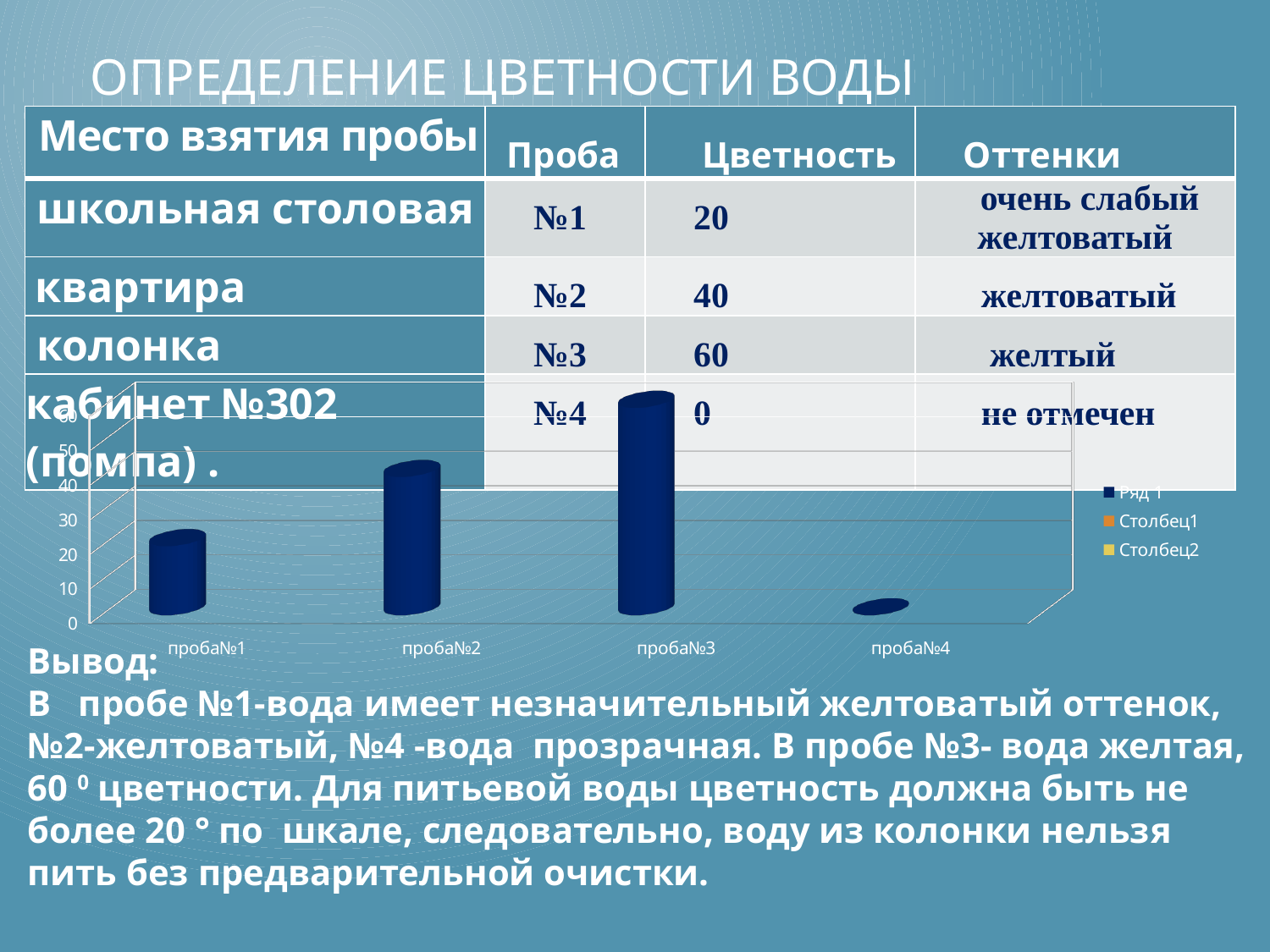
What is the colour value (цветность) plotted for проба№1? 20 Is the value for проба№2 greater or less than 30? greater What kind of chart is shown on the slide? bar chart Which is larger, the bar for проба№2 or the bar for проба№1? проба№2 What is the first entry listed in the chart legend? Ряд 1 What is the difference between the values for проба№3 and проба№1? 40 Which sample has the highest bar in the chart? проба№3 What is the colour value (цветность) plotted for проба№3? 60 Which sample has the lowest bar in the chart? проба№4 How many categories (samples) are plotted on the x axis of the chart? 4 What is the colour value (цветность) plotted for проба№4? 0 How many series does the chart legend list? 3